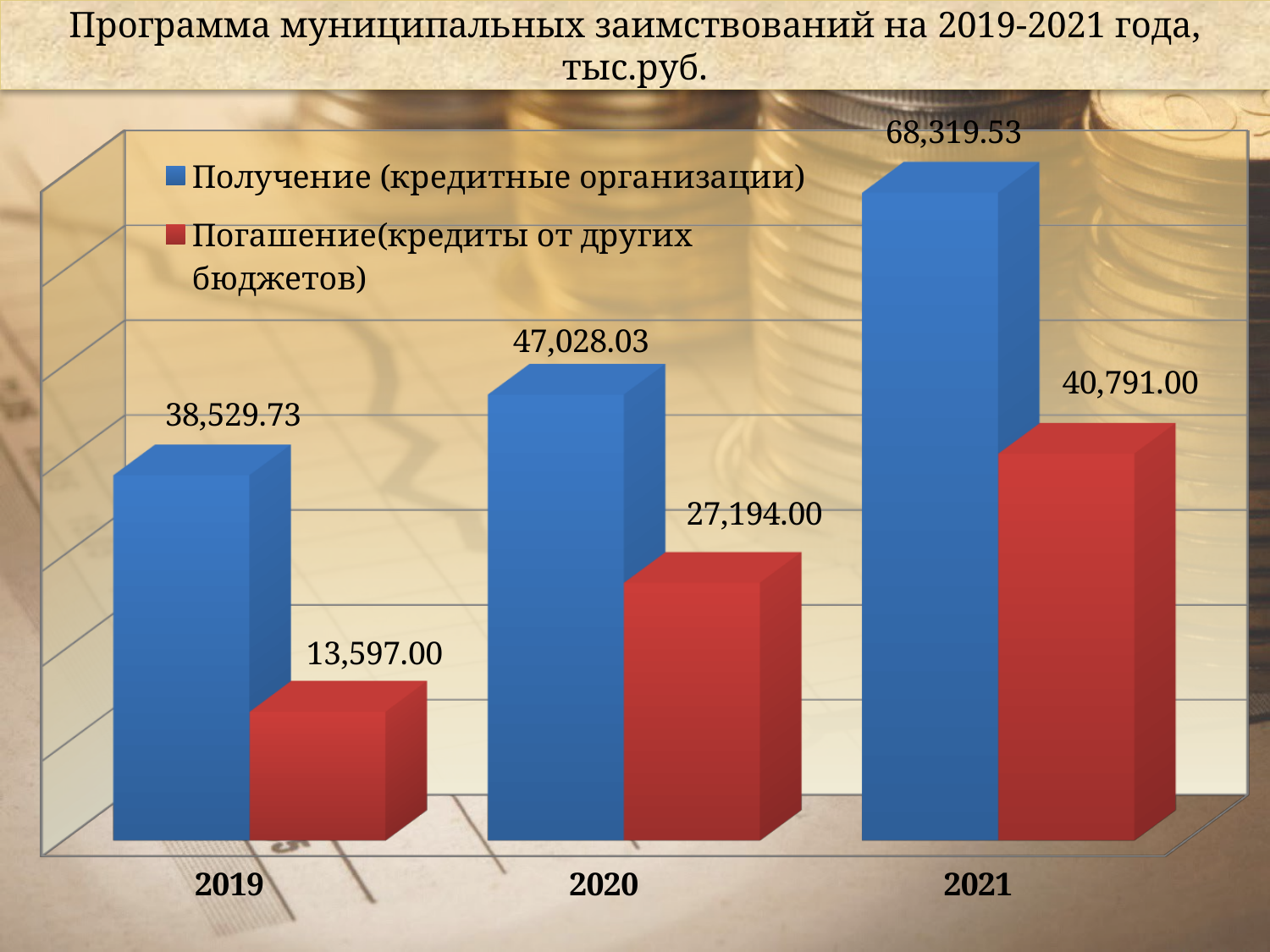
In which year is Получение (кредитные организации) highest? 2021 In which year is Погашение(кредиты от других бюджетов) lowest? 2019 What kind of chart is shown on the slide? Bar chart What is the value for Погашение(кредиты от других бюджетов) in 2021? 40,791.00 How many series does the legend list? 2 What is the value for Погашение(кредиты от других бюджетов) in 2020? 27,194.00 What is the difference between Получение (кредитные организации) and Погашение(кредиты от других бюджетов) in 2021? 27,528.53 By how much did Погашение(кредиты от других бюджетов) increase from 2019 to 2020? 13,597.00 Which is larger in 2020: Получение (кредитные организации) or Погашение(кредиты от других бюджетов)? Получение (кредитные организации) What is the value for Получение (кредитные организации) in 2019? 38,529.73 How many years are shown on the x axis? 3 What is the value for Получение (кредитные организации) in 2021? 68,319.53